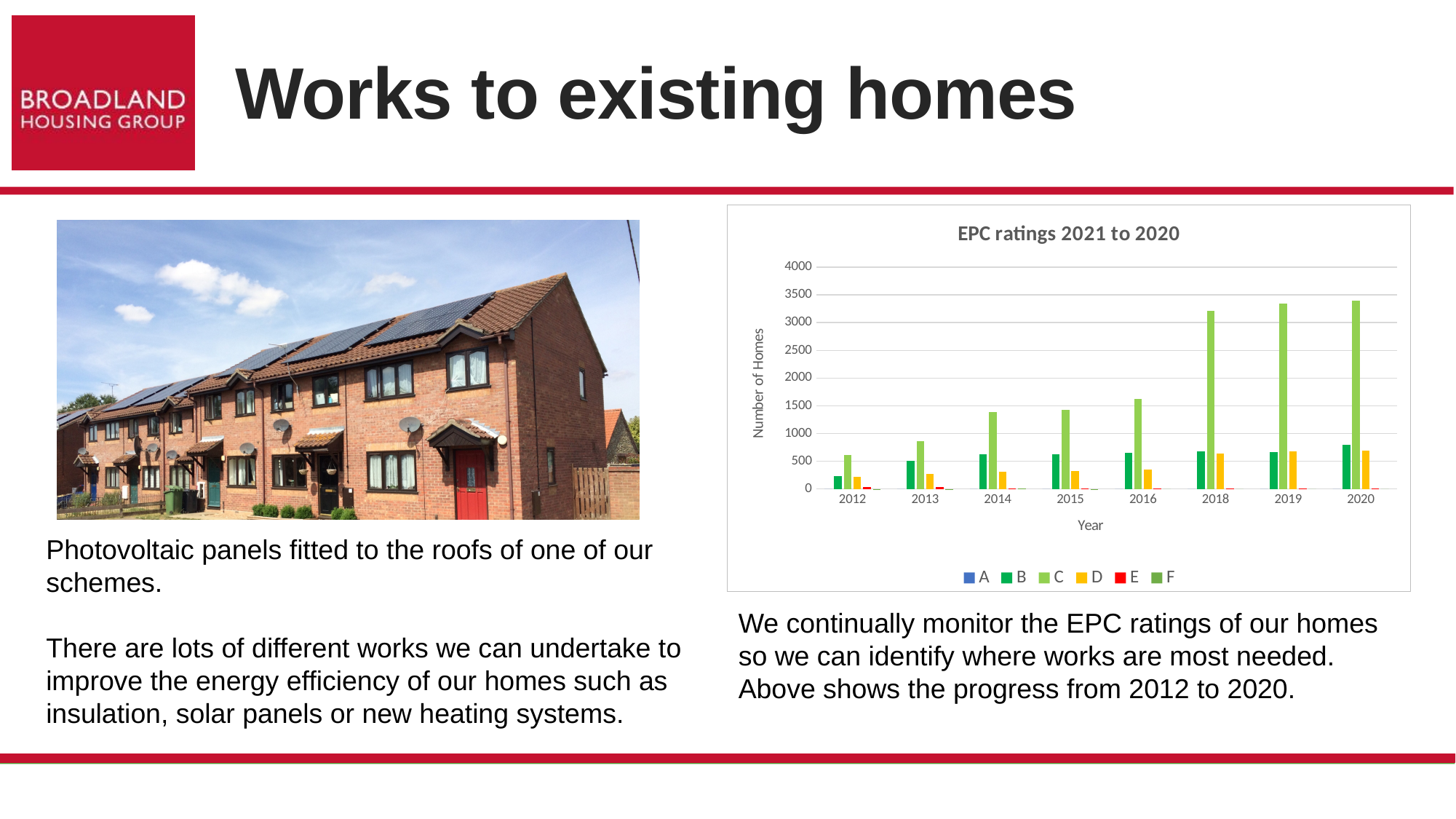
What is the title of the chart? EPC ratings 2021 to 2020 How many years are shown on the x axis of the chart? 8 Is the value for series C in 2020 greater or less than 3000? greater Is the value for series C in 2016 greater or less than 2000? less In which year is the value for series C highest? 2020 Is the value for series B in 2020 greater or less than 500? greater Which is larger in 2014, the value for series B or series D? B Does the value for series C generally rise or fall from 2012 to 2020? rise How many series does the chart legend list? 6 What is the label of the vertical axis of the chart? Number of Homes What type of chart is shown on the slide? bar chart